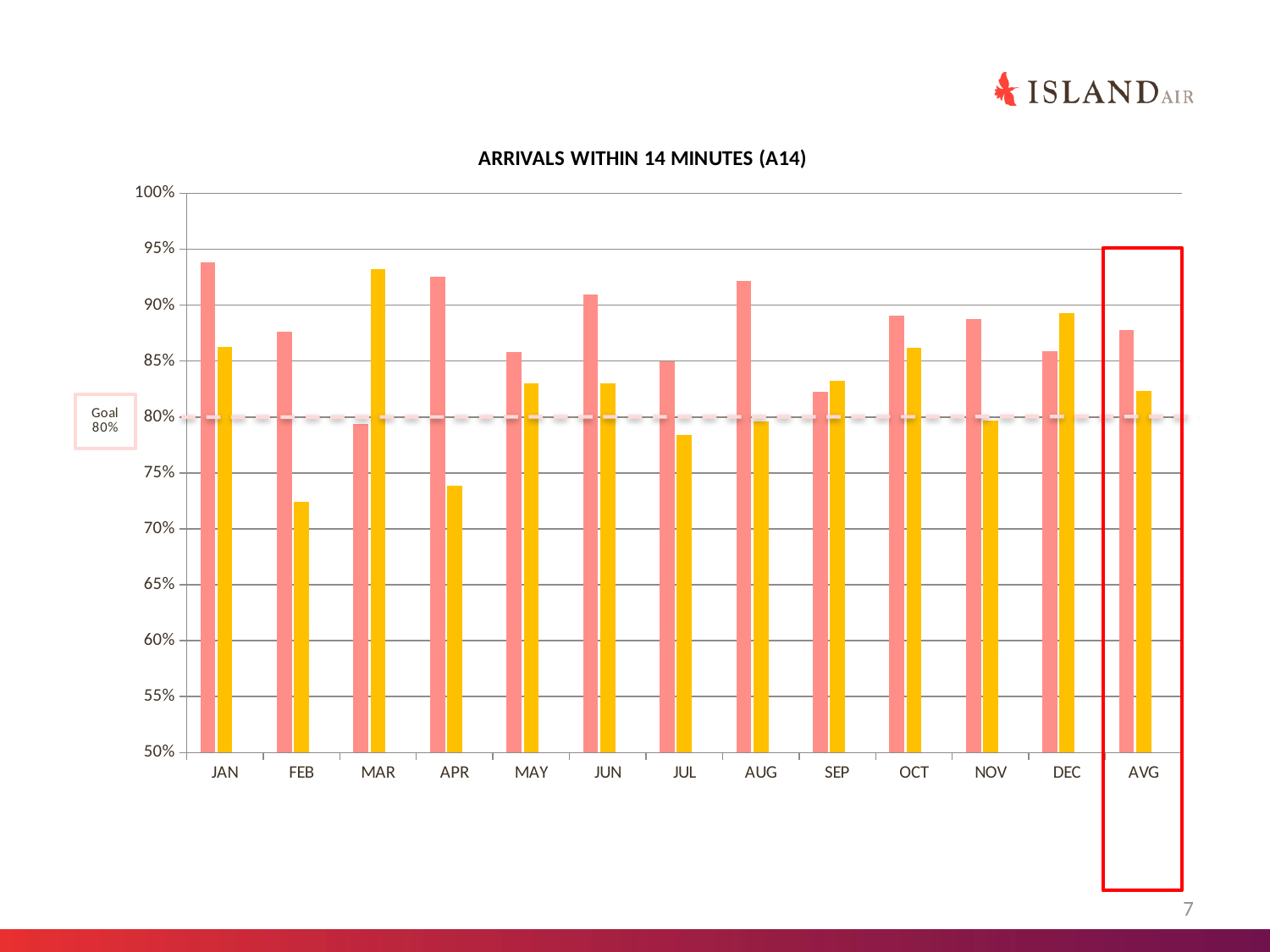
What is the title of the chart? ARRIVALS WITHIN 14 MINUTES (A14) How many categories are shown along the x axis of the chart? 13 Which month has the lowest yellow bar? FEB Is the value of the pink bar for JAN greater or less than 90%? greater Which month has the highest yellow bar? MAR What goal value is marked by the dashed line on the chart? 80% Is the value of the pink bar for AVG greater or less than 85%? greater Is the value of the yellow bar for JUL greater or less than 80%? less What kind of chart is shown on the slide? bar chart For FEB, which bar is larger, the pink bar or the yellow bar? pink bar